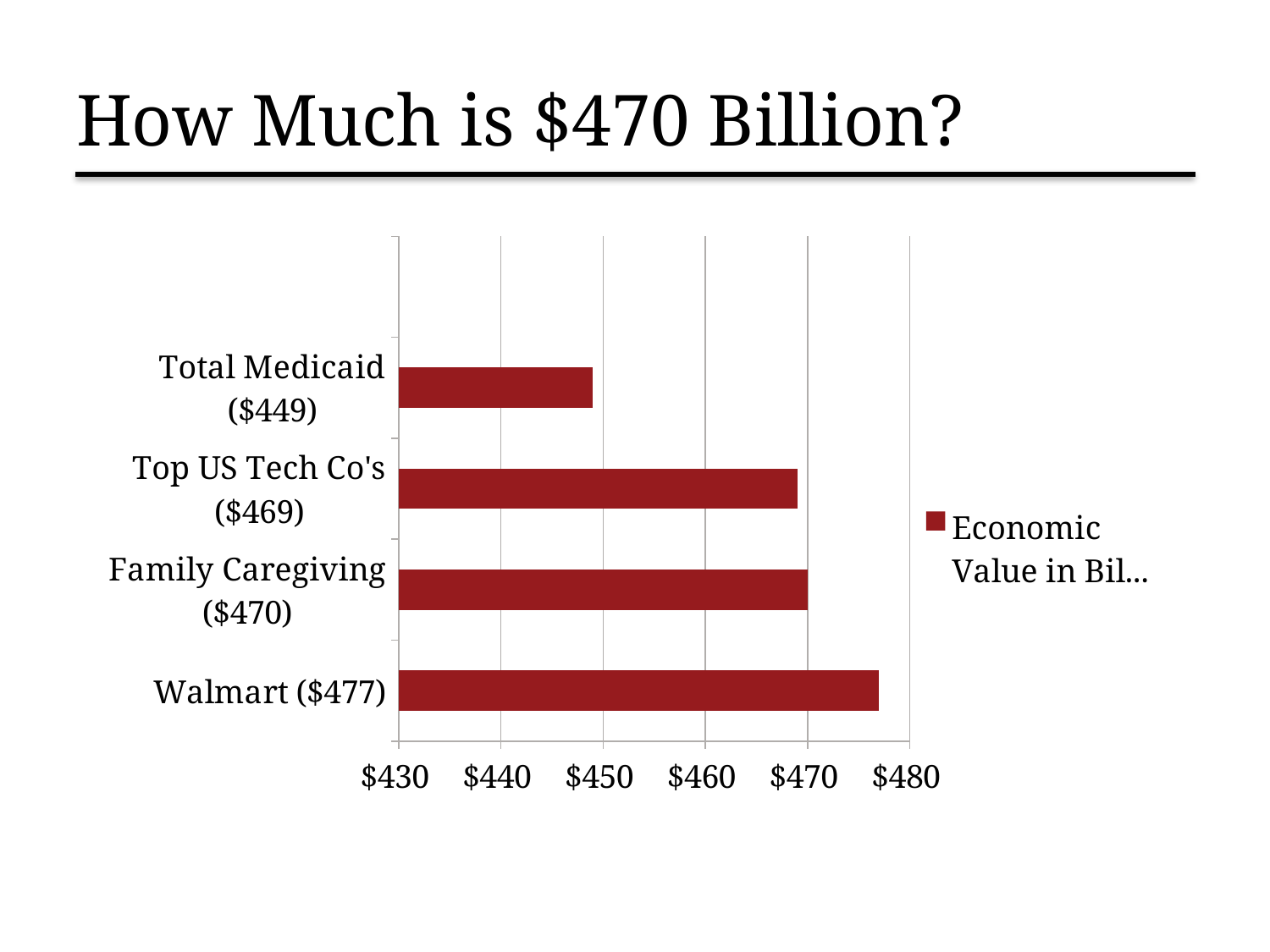
Which is larger, the value for Walmart or the value for Total Medicaid? Walmart Which category has the highest value? Walmart What is the value shown for Total Medicaid? $449 How many categories are shown in the chart? 4 Is the value for Total Medicaid greater or less than $460? less What is the difference between the Walmart value and the Family Caregiving value? $7 What kind of chart is shown on the slide? bar chart Which category has the lowest value? Total Medicaid What is the value shown for Family Caregiving? $470 What is the value shown for Walmart? $477 What is the value shown for Top US Tech Co's? $469 What is the difference between the Top US Tech Co's value and the Total Medicaid value? $20